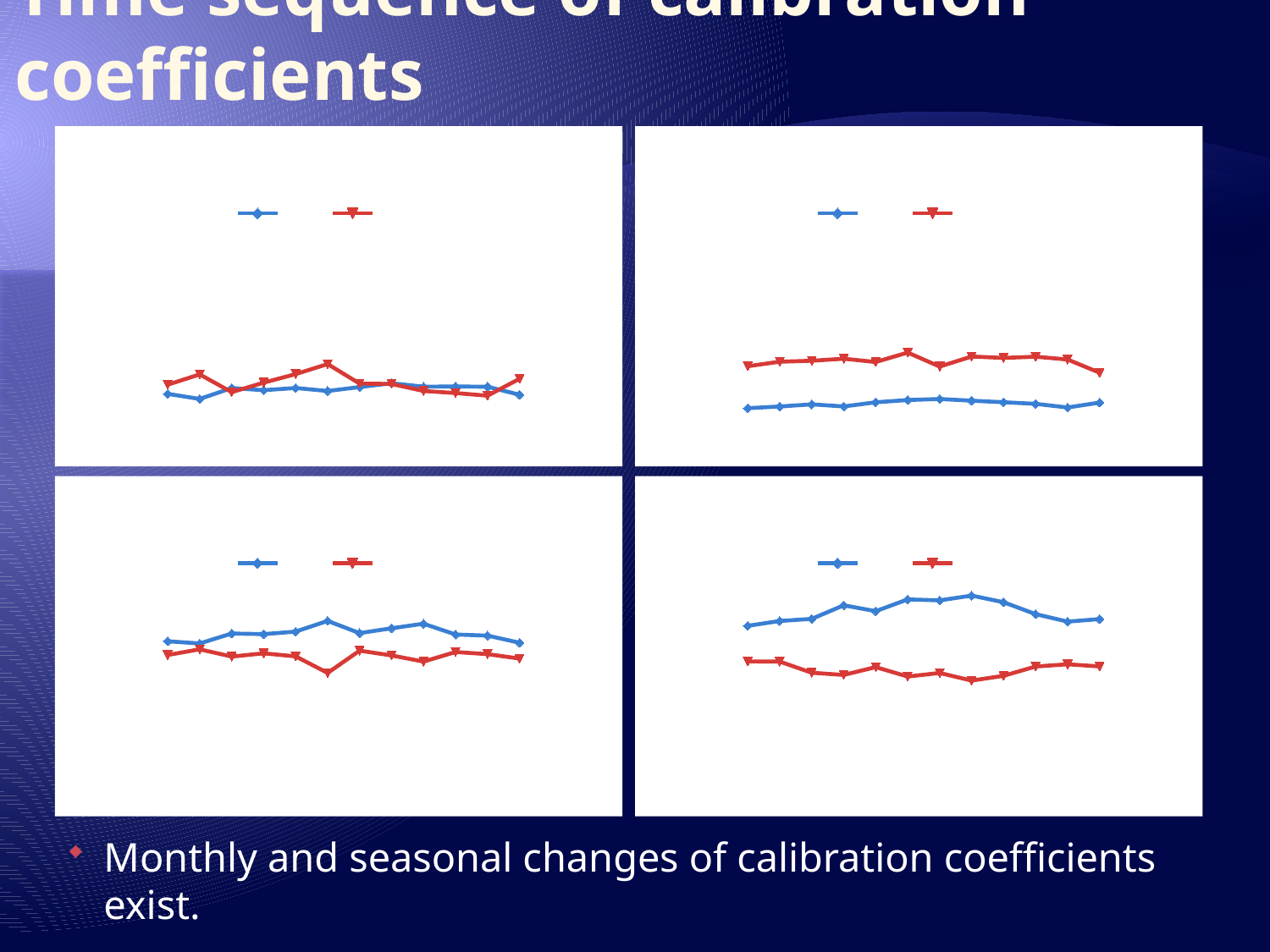
How many data points does the blue series in the top-left chart have? 12 How many data points does the blue series in the bottom-left chart have? 12 What kind of chart is the bottom-right chart? line chart What kind of chart is the top-left chart? line chart What marker shape does the red series use in the top-left chart? triangle How many data points does the red series in the top-right chart have? 12 How many series does the legend of the top-left chart list? 2 How many series does the legend of the bottom-right chart list? 2 How many charts are shown on the slide? 4 In the top-right chart, which series is plotted higher, the red one or the blue one? the red series In the bottom-left chart, which series is plotted higher, the red one or the blue one? the blue series In the bottom-right chart, which series is plotted higher, the red one or the blue one? the blue series